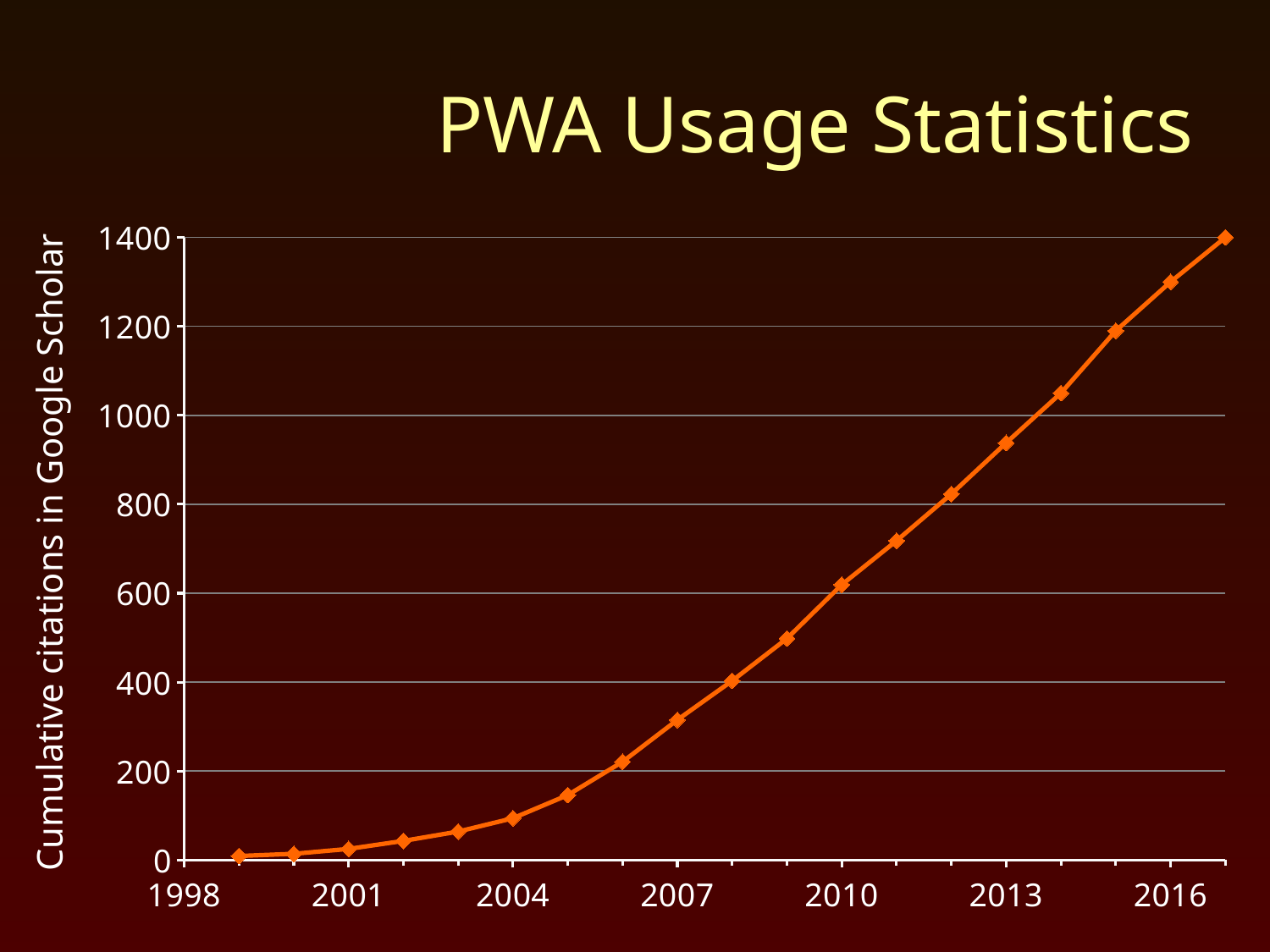
Is the value for 2013 greater or less than 800? greater Which year has the lowest cumulative citations? 1999 What is the cumulative citations value for 2017? 1400 Is the value for 2016 greater or less than 1200? greater What is the label on the vertical axis? Cumulative citations in Google Scholar Which year has the highest cumulative citations? 2017 Is the value for 2005 greater or less than 200? less Which year has more cumulative citations, 2007 or 2011? 2011 What kind of chart is shown on the slide? line chart What is the title of the chart? PWA Usage Statistics How many data points are plotted on the line? 19 Do the values rise or fall from 1999 to 2017? rise